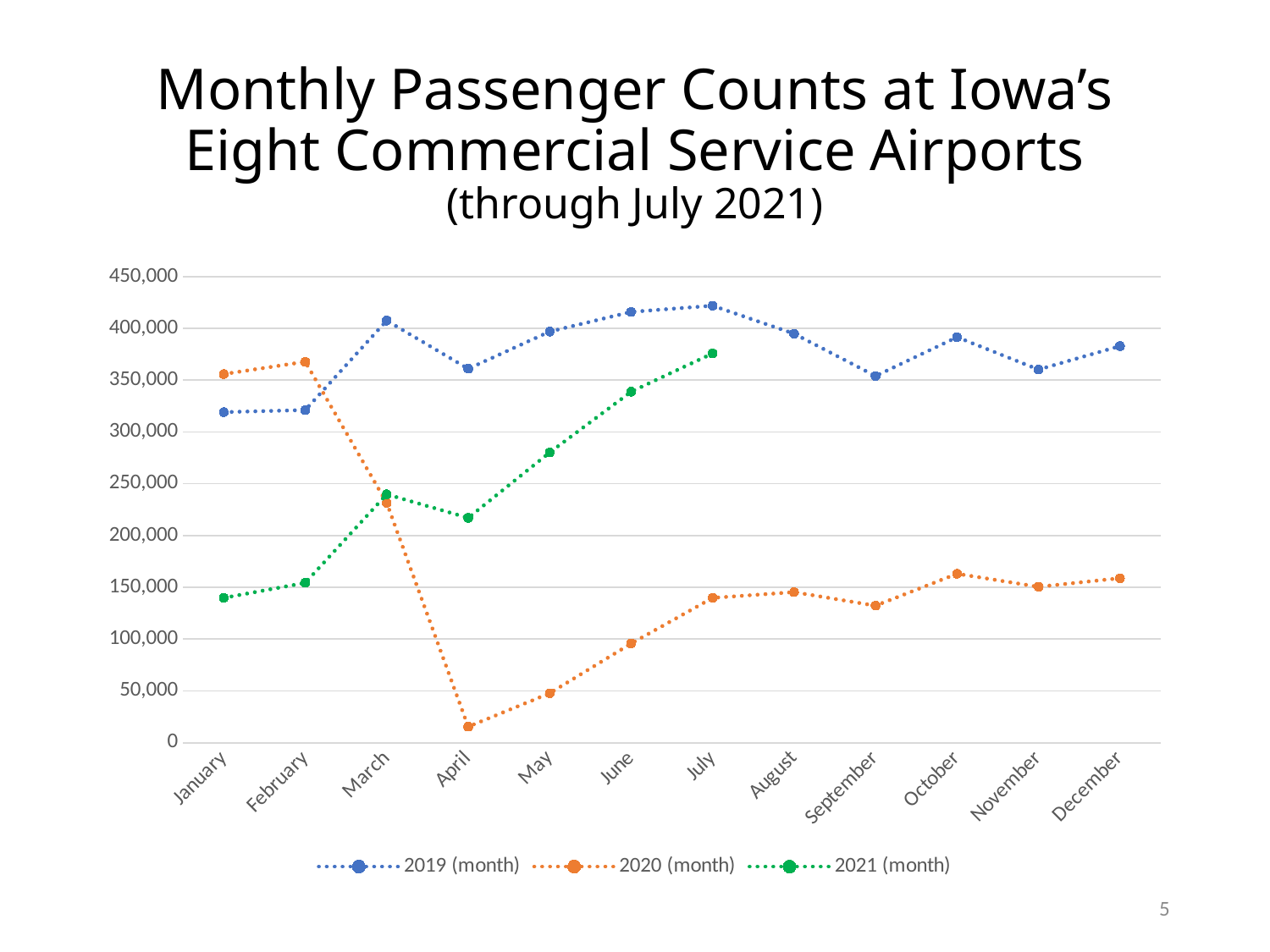
Is the 2020 (month) value for December greater or less than 200,000? less How many months are shown along the x axis? 12 In which month is the 2020 (month) value lowest? April What kind of chart is shown on the slide? line chart Is the 2021 (month) value for July greater or less than 350,000? greater Does the 2021 (month) series rise or fall from April to July? rise How many series does the legend list? 3 Is the 2019 (month) value for March greater or less than 400,000? greater Which series has the larger value in June: 2020 (month) or 2021 (month)? 2021 (month) Which series has the larger value in January: 2019 (month) or 2020 (month)? 2020 (month) In which month is the 2021 (month) value highest? July